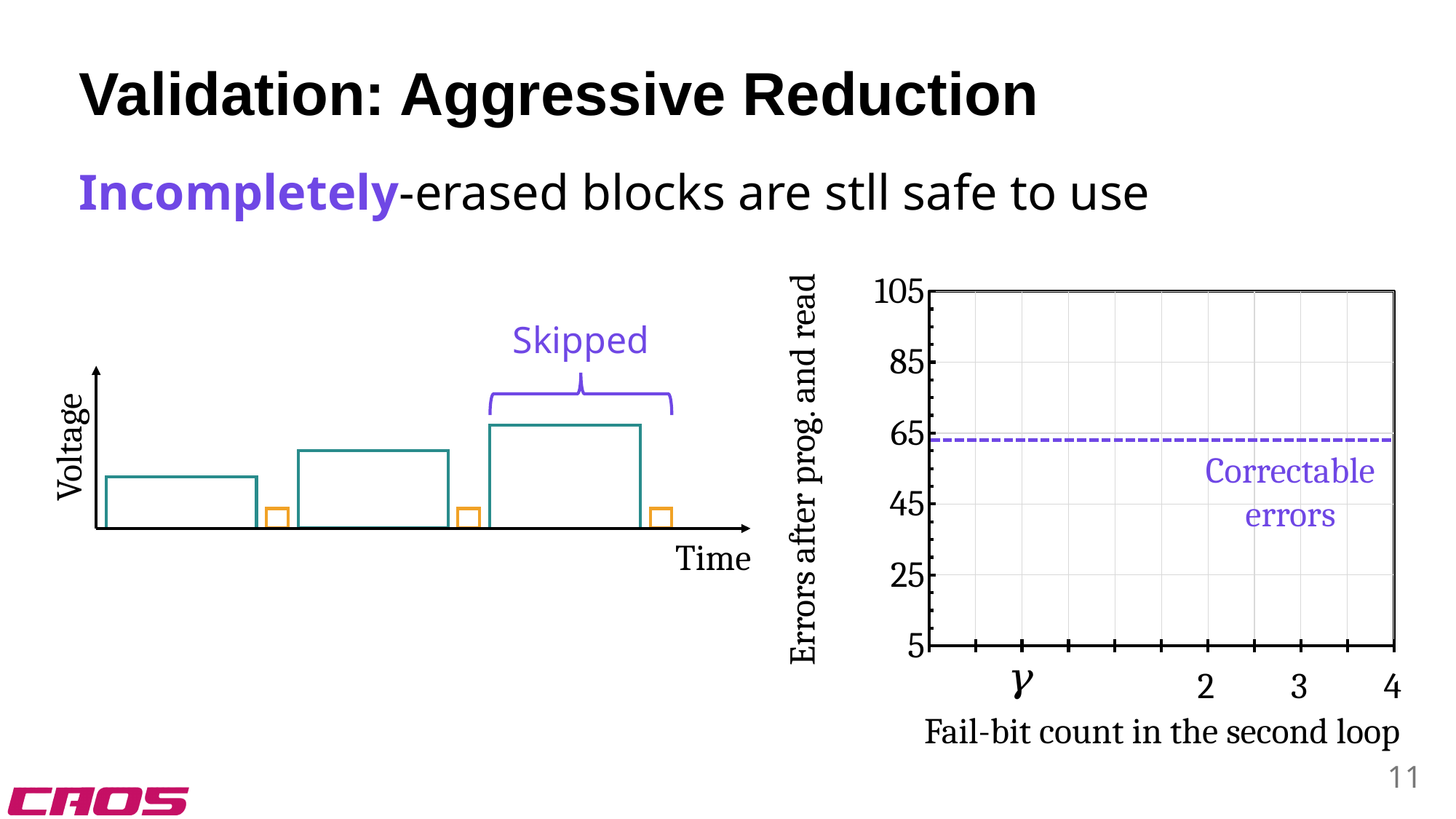
On the right chart, is the dashed 'Correctable errors' line greater or less than 45? greater On the right chart, is the dashed 'Correctable errors' line greater or less than 85? less On the left voltage-versus-time diagram, how many large teal pulses are drawn? 3 On the right chart, what is the title of the y axis? Errors after prog. and read On the right chart, what is the title of the x axis? Fail-bit count in the second loop